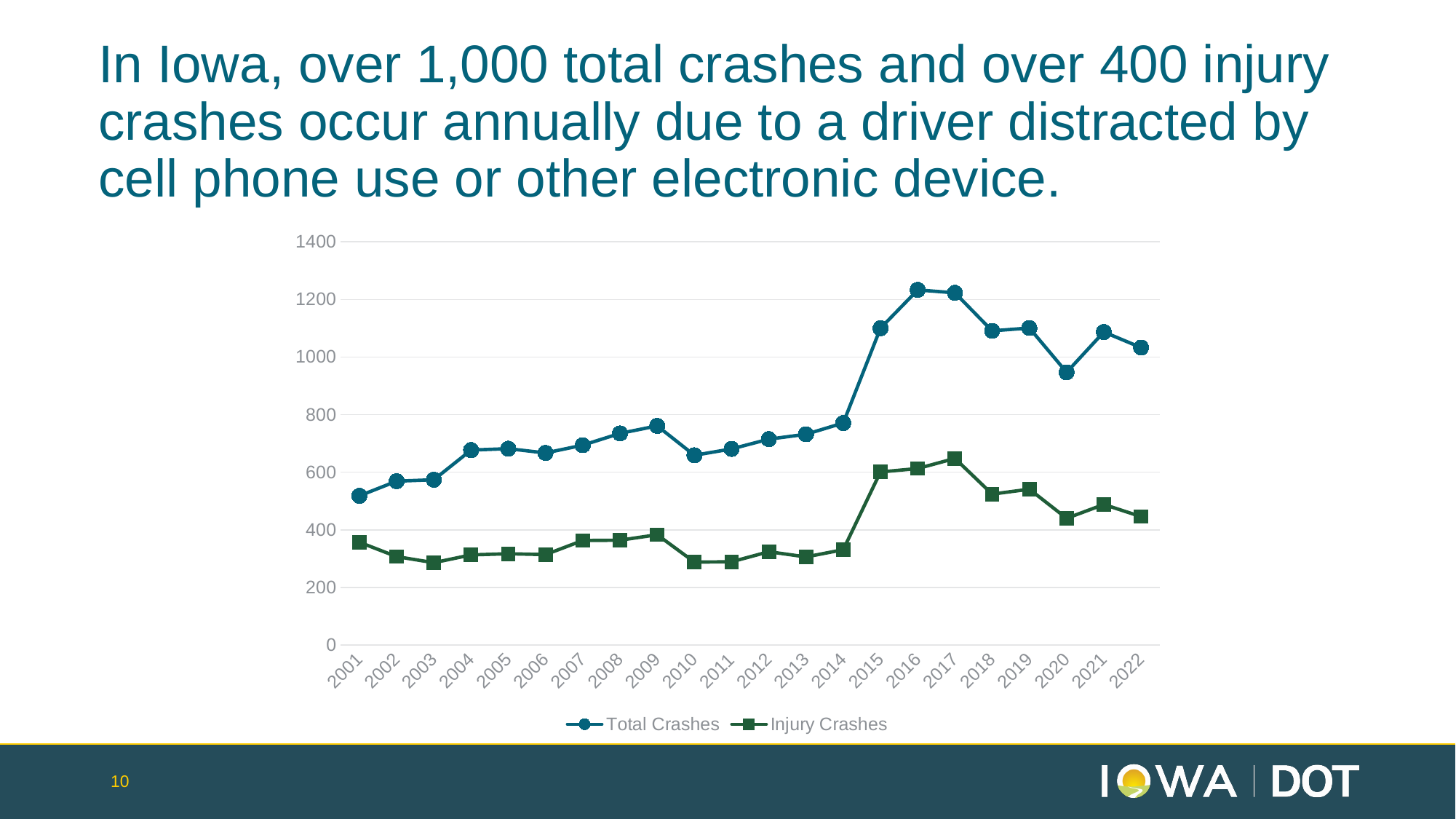
Is the value for Total Crashes in 2020 greater or less than 1000? less Is the value for Total Crashes in 2015 greater or less than 1000? greater Is the value for Injury Crashes in 2017 greater or less than 600? greater What are the two series named in the legend? Total Crashes and Injury Crashes How many years are plotted along the x axis? 22 Do Total Crashes generally rise or fall from 2001 to 2009? rise What kind of chart is shown on the slide? Line chart How many series does the legend list? 2 Which is larger, Total Crashes in 2014 or Total Crashes in 2015? 2015 Which year has the lowest value for Total Crashes? 2001 Which is larger, Injury Crashes in 2014 or Injury Crashes in 2015? 2015